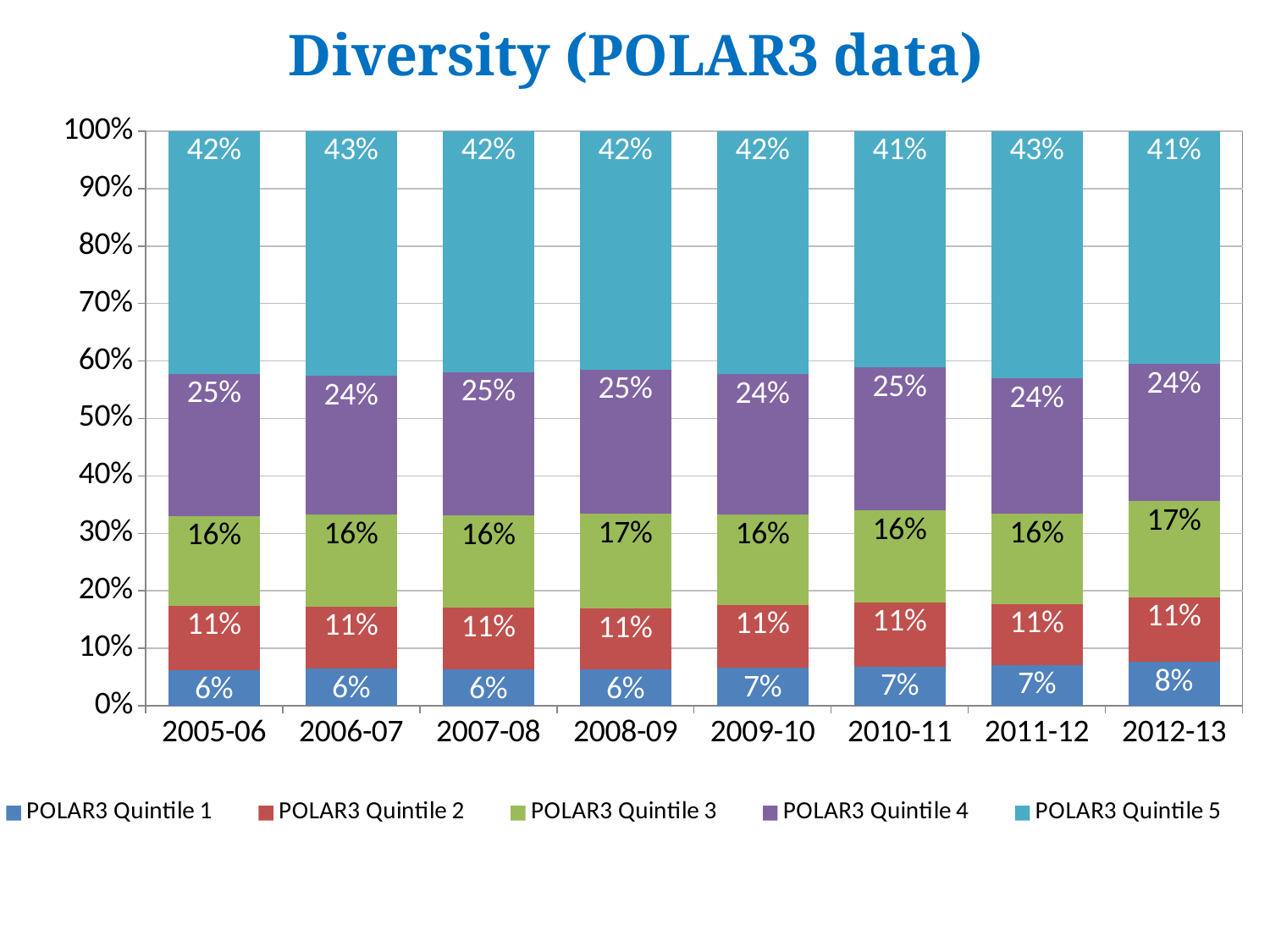
How many years are shown on the x axis? 8 What is the value for POLAR3 Quintile 1 in 2012-13? 8% What percentage does POLAR3 Quintile 5 account for in 2005-06? 42% In which year is the POLAR3 Quintile 1 share the highest? 2012-13 What kind of chart is shown on the slide? Stacked bar chart In 2005-06, which is larger: POLAR3 Quintile 4 or POLAR3 Quintile 3? POLAR3 Quintile 4 How many series does the legend list? 5 Does the POLAR3 Quintile 1 share rise or fall from 2005-06 to 2012-13? Rise What is the title of the chart? Diversity (POLAR3 data) What is the value for POLAR3 Quintile 4 in 2011-12? 24% What is the difference between the POLAR3 Quintile 5 and POLAR3 Quintile 1 values in 2012-13? 33 percentage points What is the value for POLAR3 Quintile 3 in 2008-09? 17%